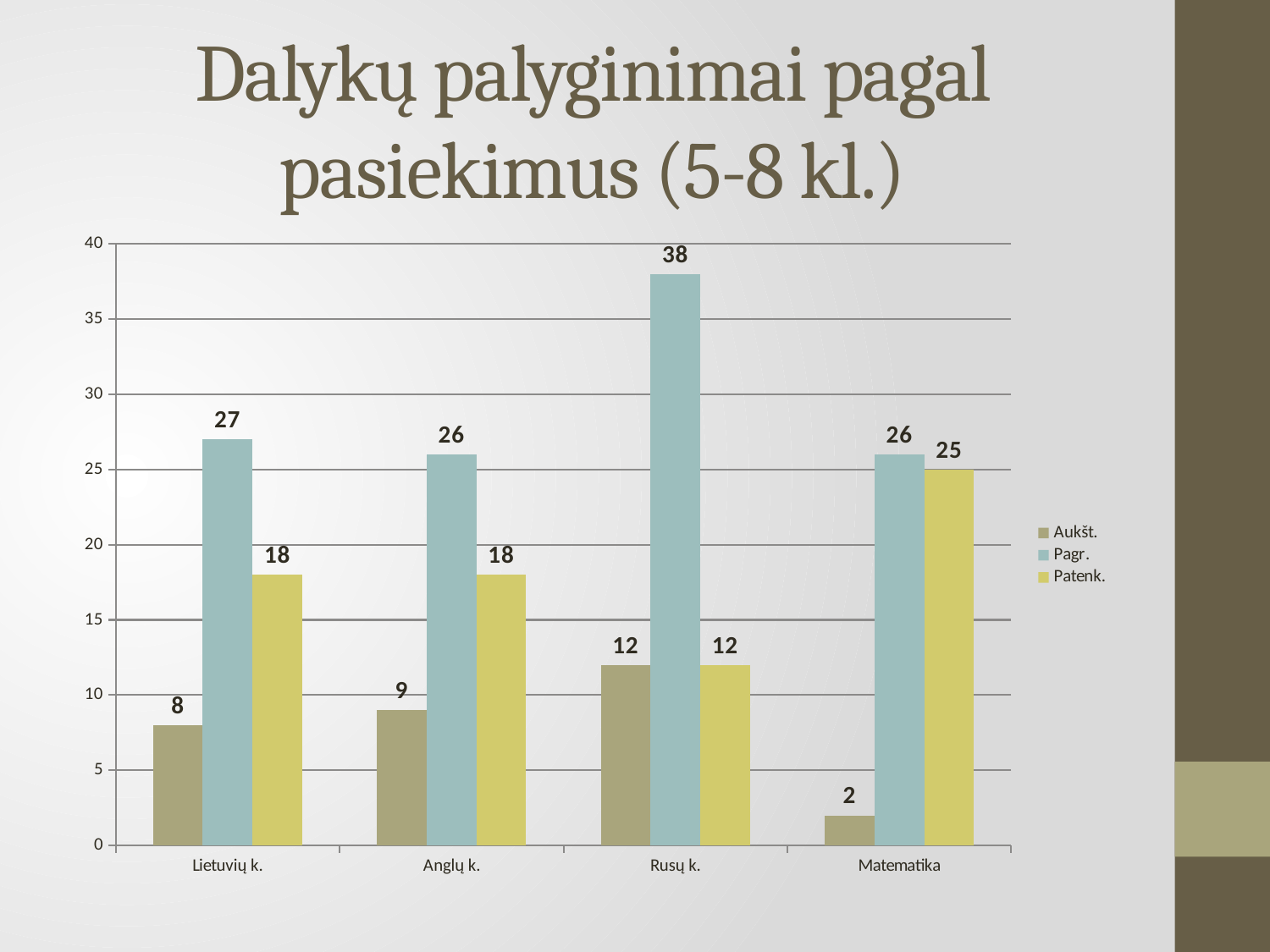
What is the title of the chart on the slide? Dalykų palyginimai pagal pasiekimus (5-8 kl.) What is the value for Patenk. in Lietuvių k.? 18 What is the difference between the Pagr. and Patenk. values in Rusų k.? 26 How many categories are shown on the x axis? 4 What kind of chart is shown on the slide? Bar chart How many series does the legend list? 3 Which category has the lowest Aukšt. value? Matematika Which category has the highest Pagr. value? Rusų k. What is the total of the three values for Lietuvių k.? 53 What is the value for Pagr. in Rusų k.? 38 What is the value for Aukšt. in Matematika? 2 Which is larger: the Patenk. value for Matematika or the Patenk. value for Anglų k.? Matematika